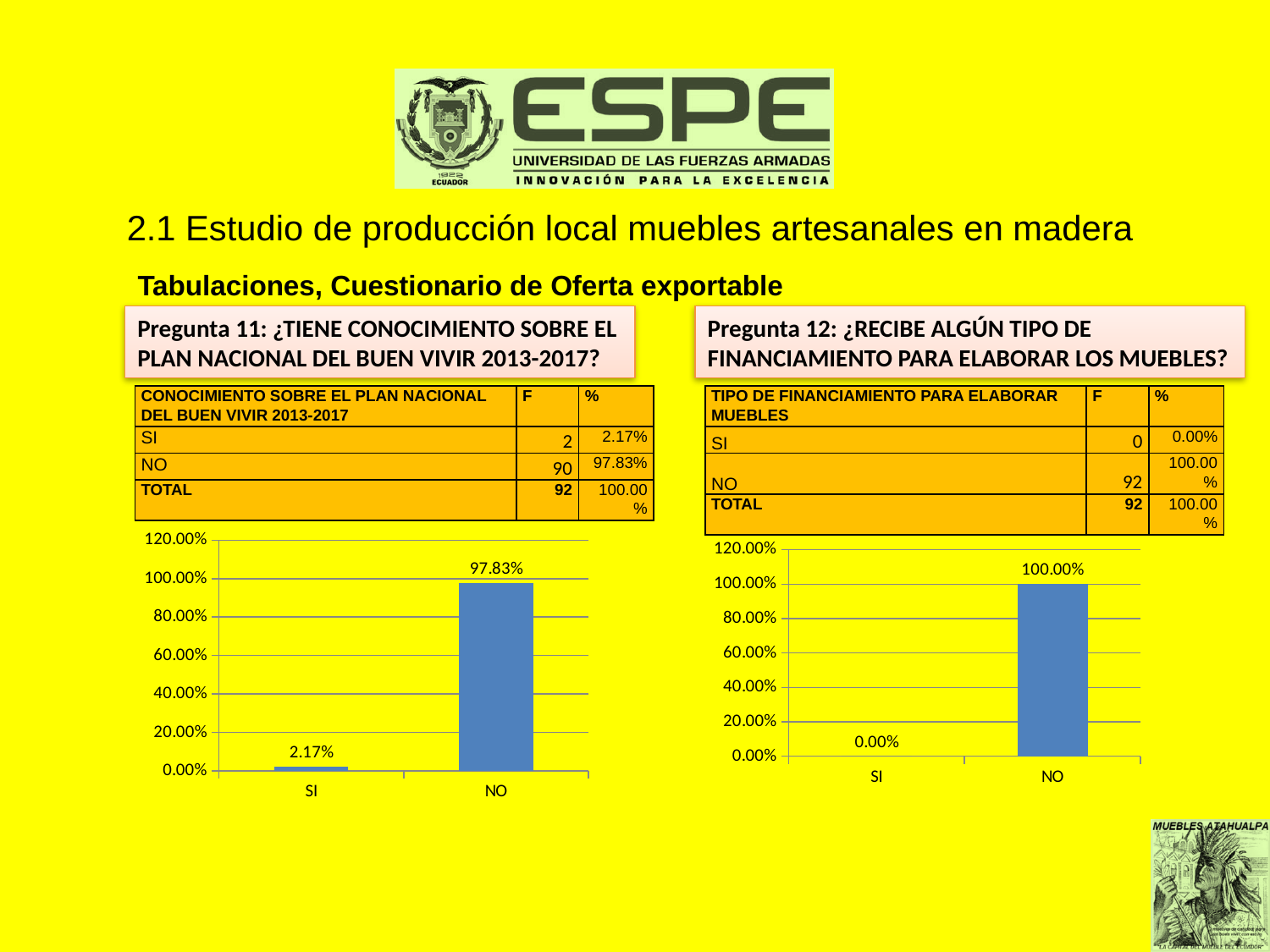
What is the highest tick value shown on the y axis of the right chart (Pregunta 12)? 120.00% In the right chart (Pregunta 12), what is the value for SI? 0.00% In the left chart (Pregunta 11), is the value for NO greater or less than 80.00%? greater In the left chart (Pregunta 11), which category has the highest value? NO In the right chart (Pregunta 12), what is the value for NO? 100.00% What kind of chart is the left chart (Pregunta 11)? bar chart In the left chart (Pregunta 11), what is the difference between the values for NO and SI? 95.66% In the right chart (Pregunta 12), which category has the lowest value? SI In the left chart (Pregunta 11), what is the value for SI? 2.17% How many categories are shown on the x axis of the right chart (Pregunta 12)? 2 In the right chart (Pregunta 12), what is the difference between the values for NO and SI? 100.00% In the left chart (Pregunta 11), what is the value for NO? 97.83%